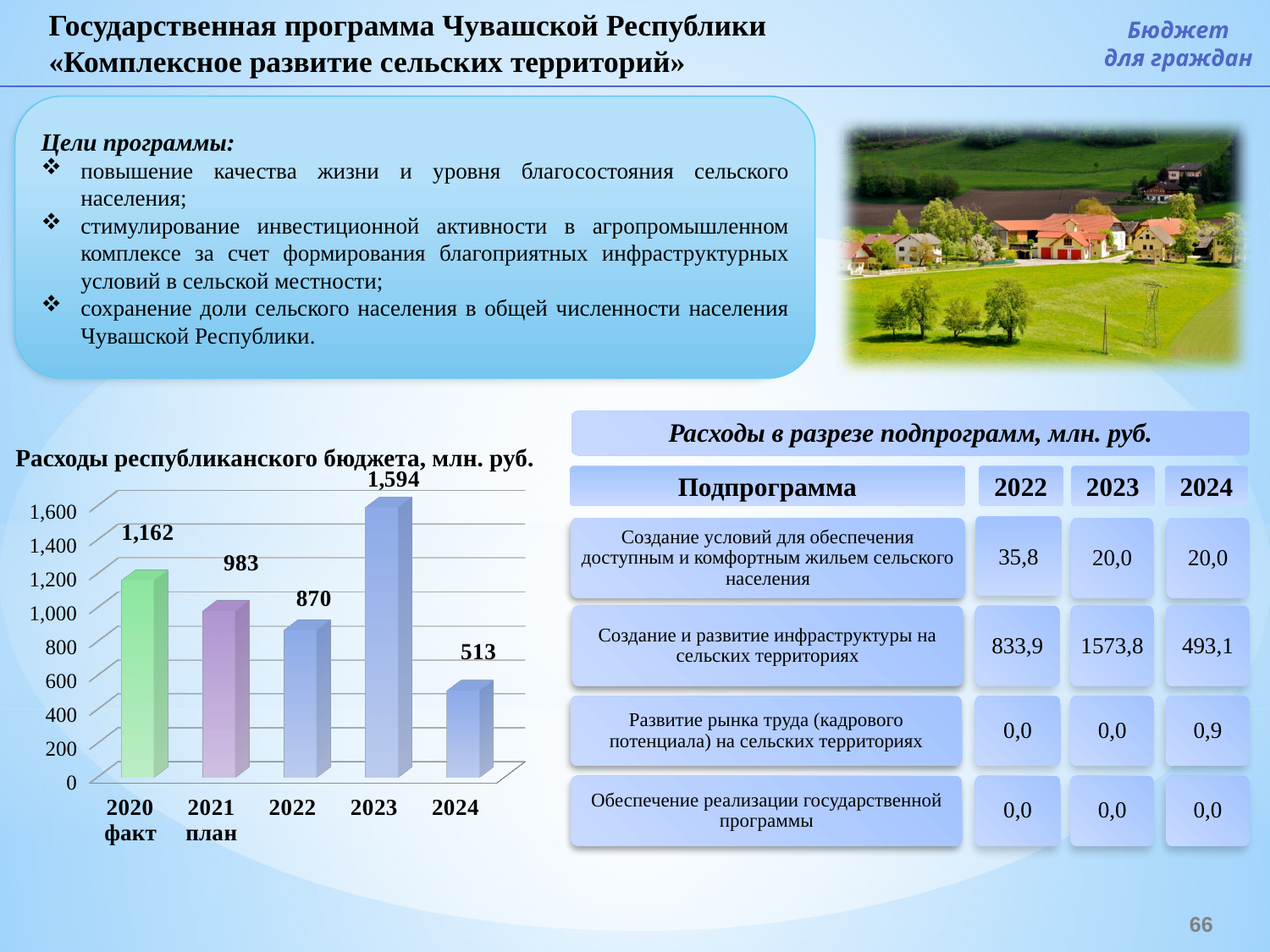
What is the value for 2020 факт in the chart? 1,162 What is the difference between the values for 2021 план and 2022 in the chart? 113 Which is larger in the chart, the value for 2020 факт or the value for 2022? 2020 факт Which year has the lowest value in the chart? 2024 What is the value for 2024 in the chart? 513 What kind of chart is shown on the slide? Bar chart What is the difference between the values for 2023 and 2024 in the chart? 1,081 What is the value for 2023 in the chart 'Расходы республиканского бюджета, млн. руб.'? 1,594 What is the title of the chart on the slide? Расходы республиканского бюджета, млн. руб. How many bars are shown in the chart? 5 Which year has the highest value in the chart? 2023 What is the value for 2021 план in the chart? 983